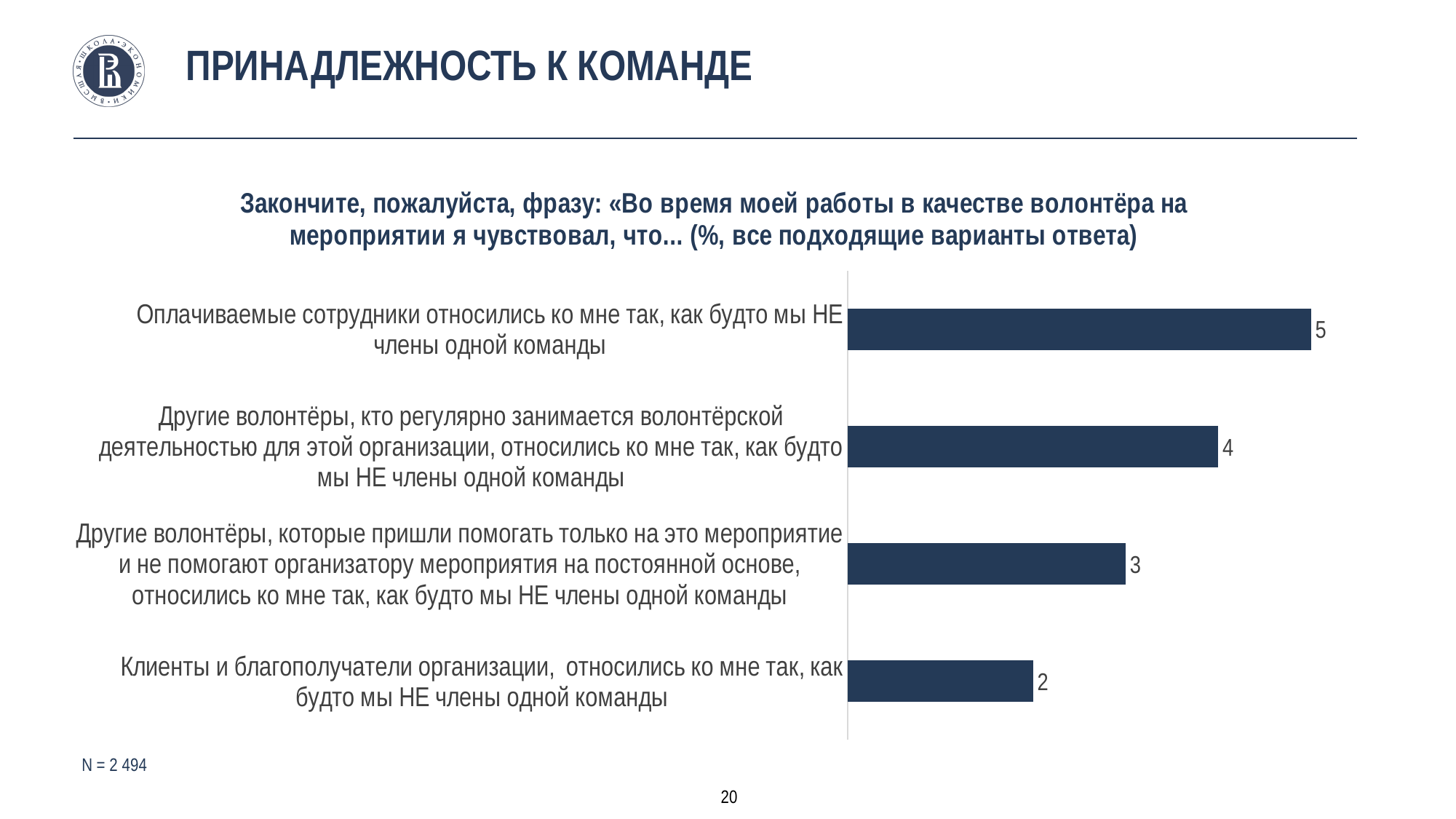
How many categories (bars) does the chart show? 4 What is the value for the category about other volunteers who came to help only at this event (пришли помогать только на это мероприятие)? 3 What is the value for «Оплачиваемые сотрудники относились ко мне так, как будто мы НЕ члены одной команды»? 5 What sample size (N) is stated on the slide? N = 2 494 Which category has the highest value? Оплачиваемые сотрудники относились ко мне так, как будто мы НЕ члены одной команды What is the difference between the value for paid employees (Оплачиваемые сотрудники) and the value for clients and beneficiaries (Клиенты и благополучатели)? 3 Which is larger: the value for regular volunteers (регулярно занимается волонтёрской деятельностью) or the value for event-only volunteers (пришли помогать только на это мероприятие)? Regular volunteers (4) What is the value for the category about other volunteers who regularly volunteer for this organisation (регулярно занимается волонтёрской деятельностью)? 4 What type of chart is shown on the slide? Bar chart What is the value for «Клиенты и благополучатели организации, относились ко мне так, как будто мы НЕ члены одной команды»? 2 Do the values rise or fall going from the top bar to the bottom bar? Fall Which category has the lowest value? Клиенты и благополучатели организации, относились ко мне так, как будто мы НЕ члены одной команды